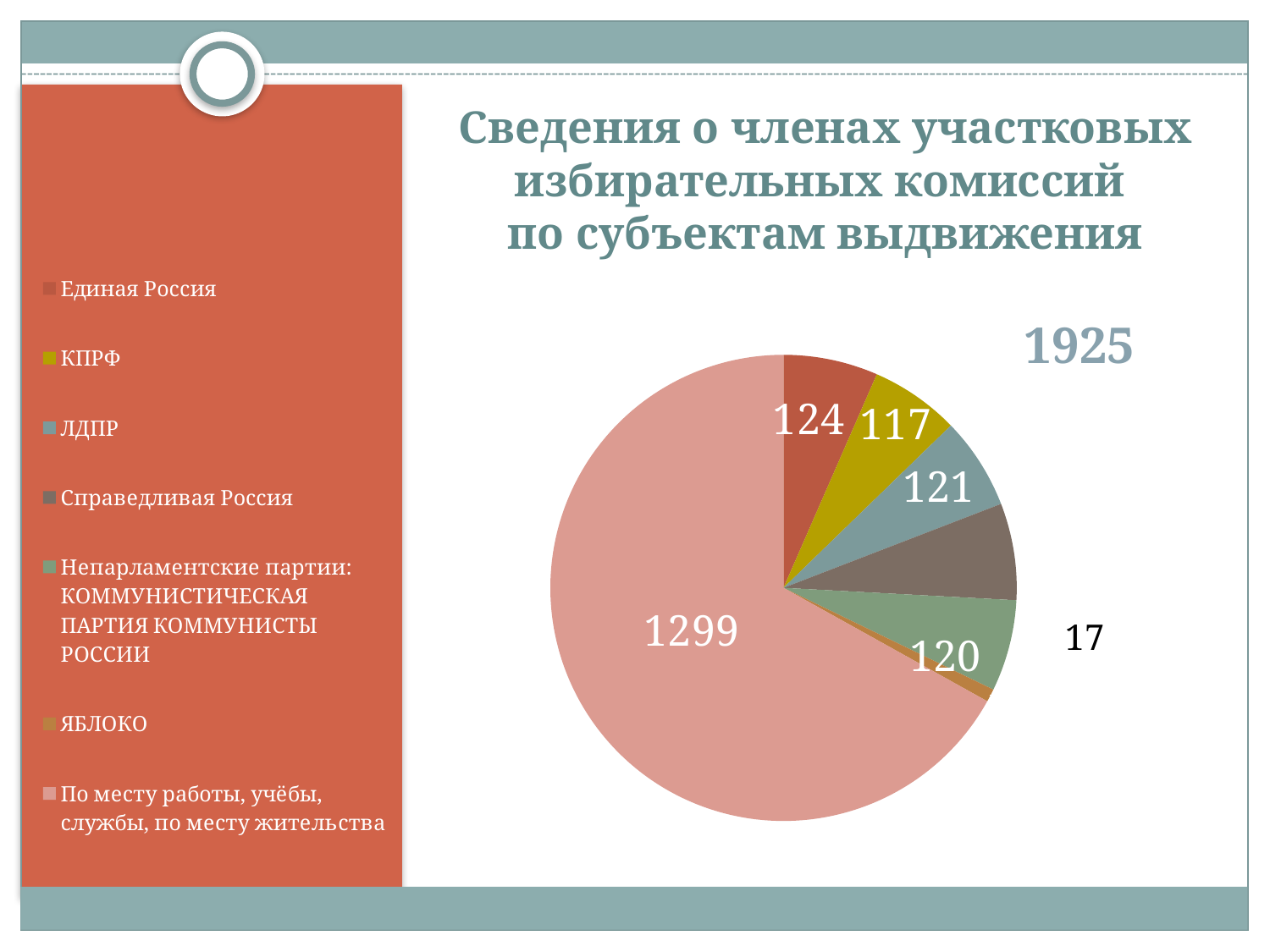
What value is shown for По месту работы, учёбы, службы, по месту жительства? 1299 What value is shown for КПРФ? 117 Which category has the largest slice of the pie? По месту работы, учёбы, службы, по месту жительства What is the difference between the values for Единая Россия and КПРФ? 7 Which is larger, the value for ЛДПР or the value for КПРФ? ЛДПР What value is shown for ЛДПР? 121 How many categories does the legend list? 7 Which category has the smallest slice of the pie? ЯБЛОКО What value is shown for Единая Россия? 124 What kind of chart is shown on the slide? pie chart What value is shown for ЯБЛОКО? 17 What value is shown for Непарламентские партии: КОММУНИСТИЧЕСКАЯ ПАРТИЯ КОММУНИСТЫ РОССИИ? 120